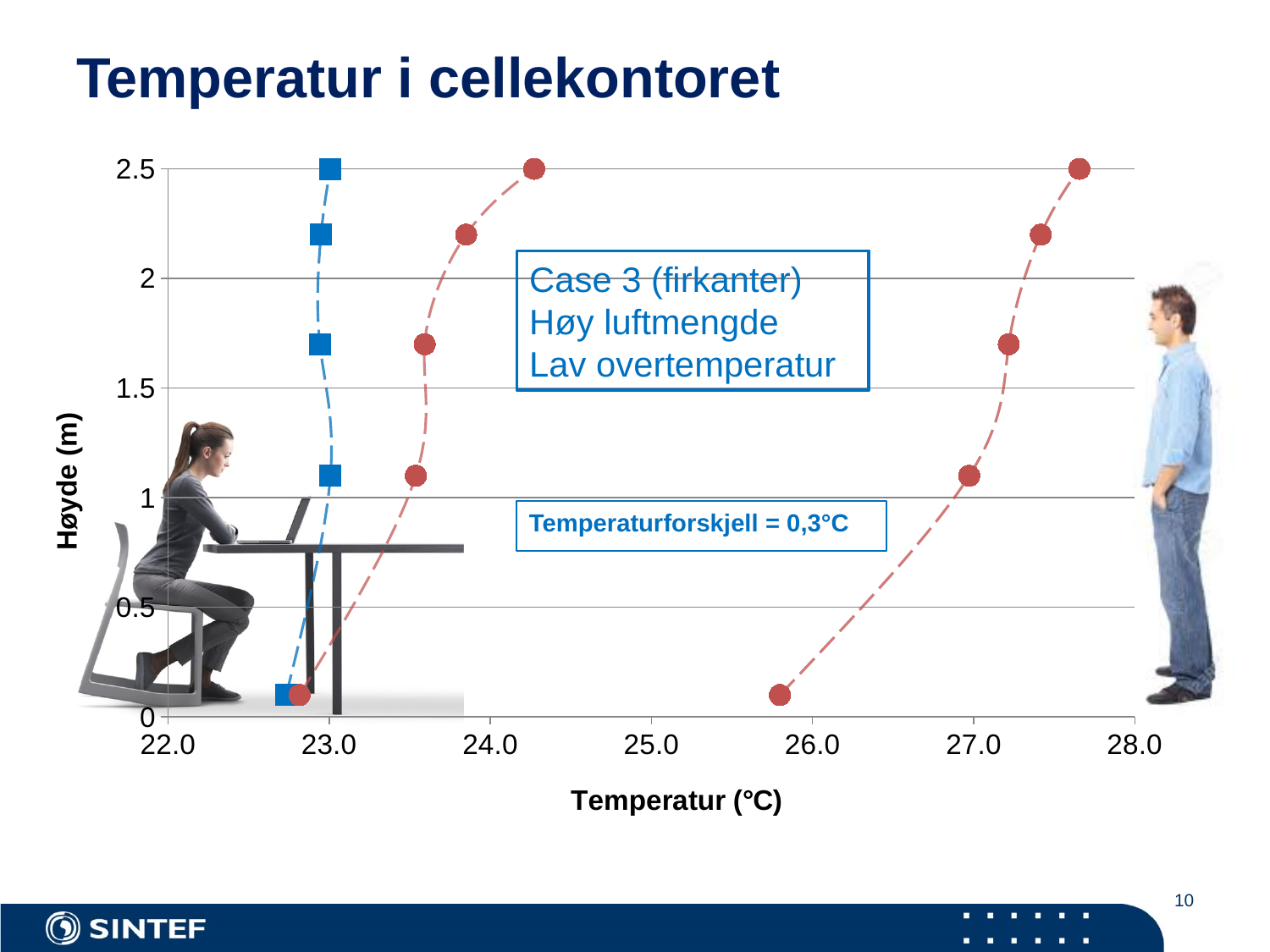
Is the temperature of the rightmost red circle series at its lowest point (near 0 m) greater or less than 25.0? greater What is the title of the chart on the slide? Temperatur i cellekontoret How many data series are plotted on the chart? 3 Which series has the highest temperature at a height of 2.5 m? the rightmost red circle series Is the temperature of the middle red circle series at a height of 2.5 m greater or less than 25.0? less Is the temperature of the blue square series at a height of 2.5 m greater or less than 24.0? less What kind of chart is shown on the slide? line chart At a height of 2.5 m, which series has the higher temperature: the blue squares or the middle red circles? the middle red circles For the rightmost red circle series, does the temperature rise or fall as height increases? rise How many data points does the blue square series have? 5 What is the label of the vertical axis? Høyde (m)